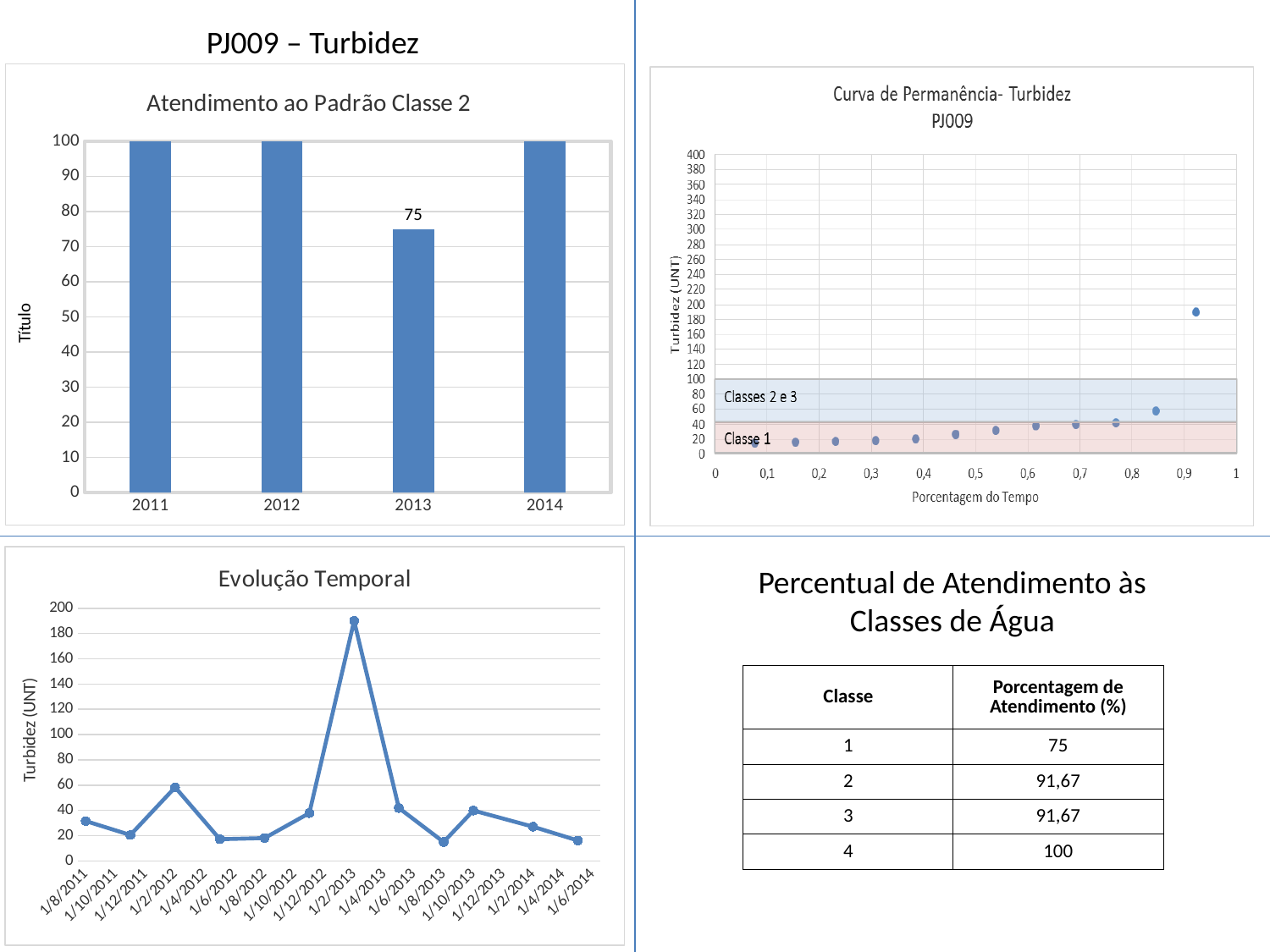
In the 'Evolução Temporal' chart, which date has the highest turbidity value? 1/2/2013 In the 'Evolução Temporal' chart, which is larger, the value for 1/2/2012 or the value for 1/6/2012? 1/2/2012 In the 'Atendimento ao Padrão Classe 2' chart, what is the value for 2011? 100 How many dates are shown on the x axis of the 'Evolução Temporal' chart? 18 In the 'Curva de Permanência- Turbidez PJ009' chart, what are the two shaded bands labelled? Classes 2 e 3 and Classe 1 In the 'Atendimento ao Padrão Classe 2' chart, what is the value for 2013? 75 In the 'Atendimento ao Padrão Classe 2' chart, what is the difference between the values for 2012 and 2013? 25 What kind of chart is 'Atendimento ao Padrão Classe 2'? bar chart What kind of chart is 'Evolução Temporal'? line chart In the 'Evolução Temporal' chart, is the value for 1/2/2013 greater or less than 180? greater How many years are shown in the 'Atendimento ao Padrão Classe 2' chart? 4 In the 'Atendimento ao Padrão Classe 2' chart, which year has the lowest value? 2013